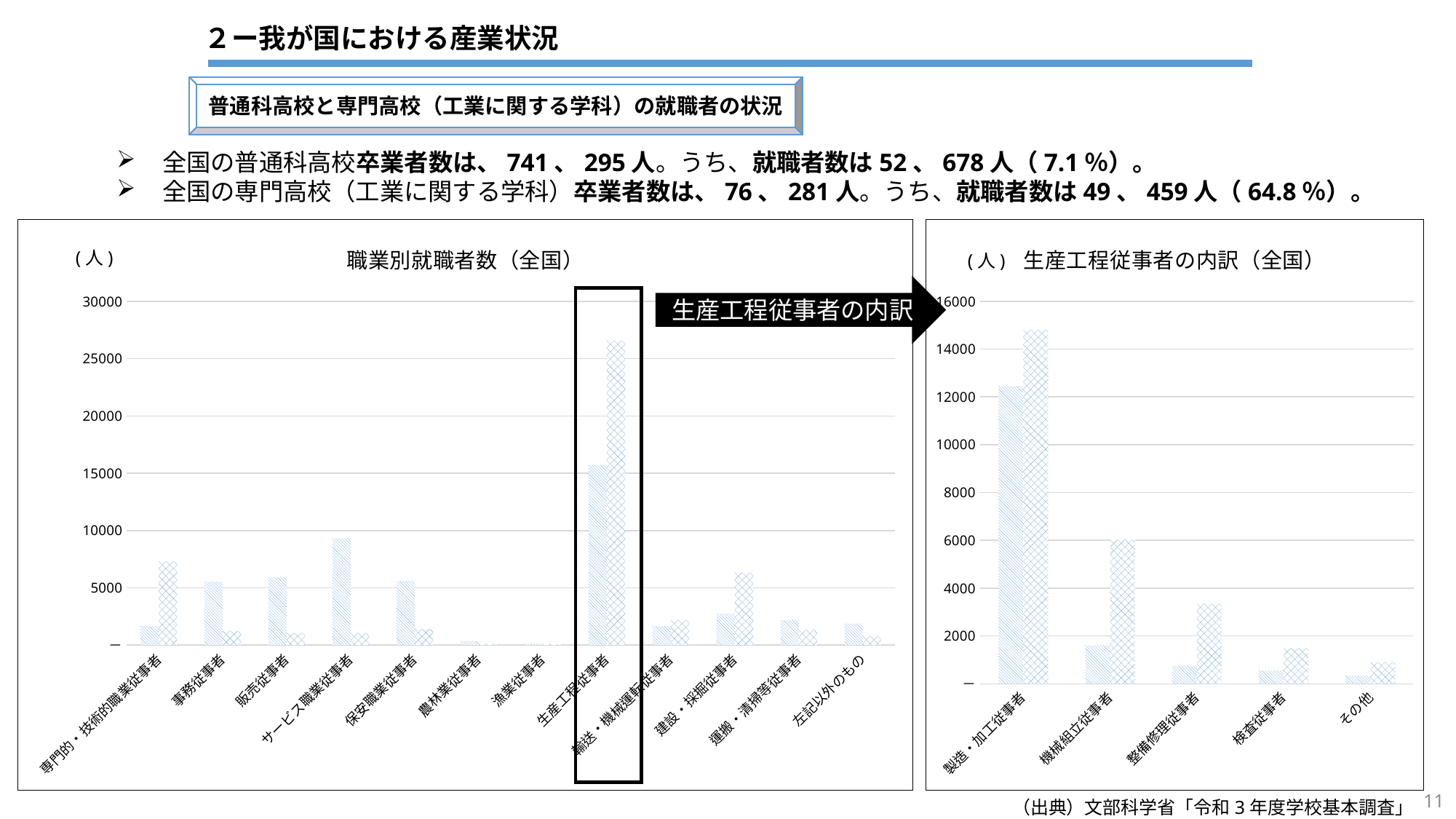
In the left chart 職業別就職者数（全国）, is the tallest bar for サービス職業従事者 greater or less than 10000? less In the left chart 職業別就職者数（全国）, is the tallest bar for 生産工程従事者 greater or less than 25000? greater In the right chart 生産工程従事者の内訳（全国）, which category has the lowest bars? その他 In the left chart 職業別就職者数（全国）, how many occupation categories are shown on the x axis? 12 What kind of chart is the left chart titled 職業別就職者数（全国）? bar chart In the right chart 生産工程従事者の内訳（全国）, how many categories are shown on the x axis? 5 In the right chart 生産工程従事者の内訳（全国）, is the tallest bar for 製造・加工従事者 greater or less than 14000? greater In the right chart 生産工程従事者の内訳（全国）, which category has the highest bar? 製造・加工従事者 In the left chart 職業別就職者数（全国）, which category has the highest bar? 生産工程従事者 In the right chart 生産工程従事者の内訳（全国）, which has taller bars: 製造・加工従事者 or 機械組立従事者? 製造・加工従事者 What unit is shown at the top of the y axis of both charts? （人）